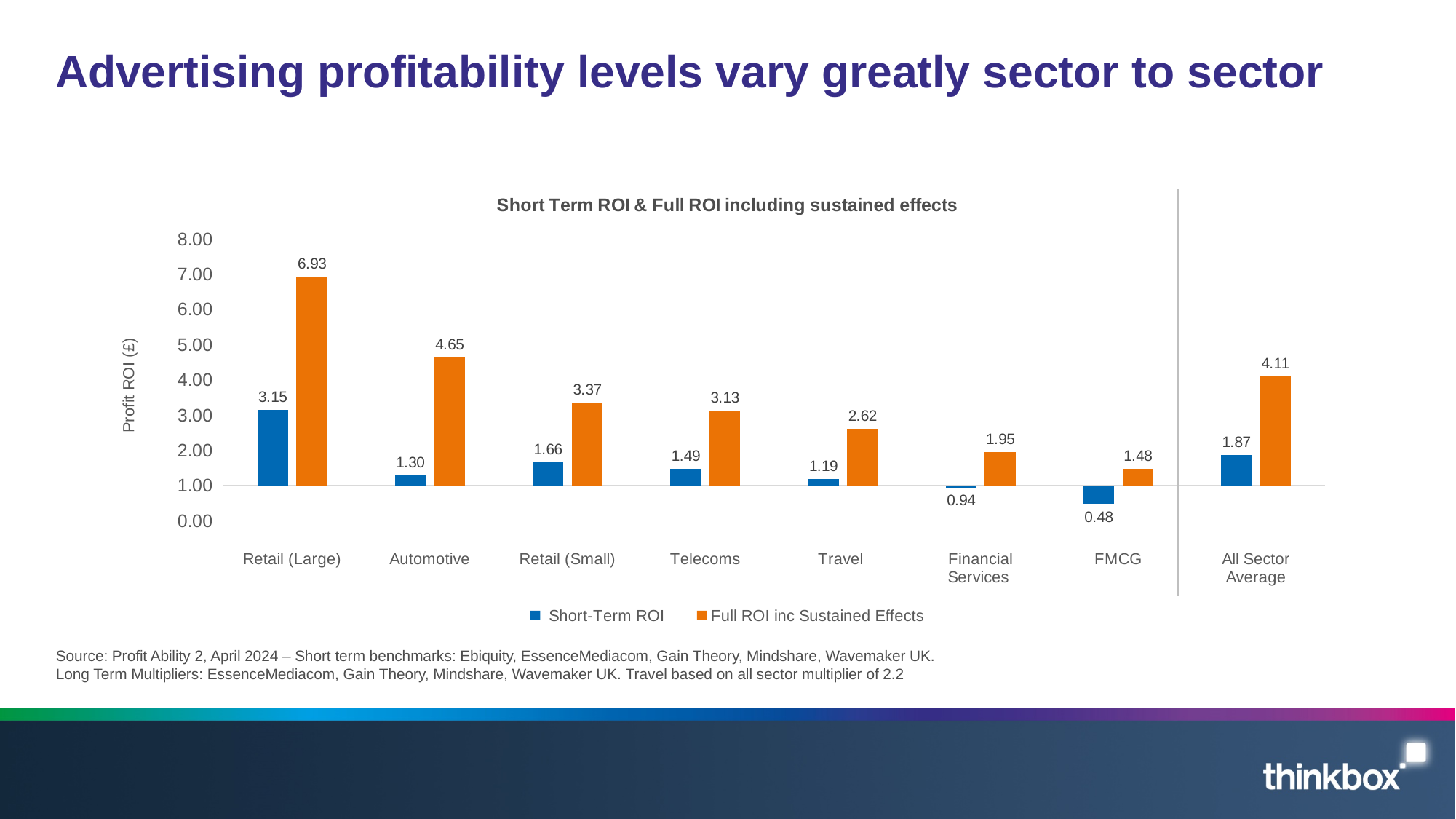
Which sector has the lowest Short-Term ROI? FMCG What is the difference between the Full ROI inc Sustained Effects and the Short-Term ROI for FMCG? 1.00 What is the Full ROI inc Sustained Effects value for Retail (Large)? 6.93 How many series does the legend list? 2 Which sector has the highest Full ROI inc Sustained Effects? Retail (Large) What is the Short-Term ROI value for Automotive? 1.30 What is the title of the chart? Short Term ROI & Full ROI including sustained effects What is the difference between the Full ROI inc Sustained Effects and the Short-Term ROI for Retail (Large)? 3.78 What is the Full ROI inc Sustained Effects value for Travel? 2.62 What kind of chart is shown on the slide? Bar chart Which is larger: the Full ROI inc Sustained Effects for Telecoms or for Retail (Small)? Retail (Small) What is the Short-Term ROI value for the All Sector Average? 1.87